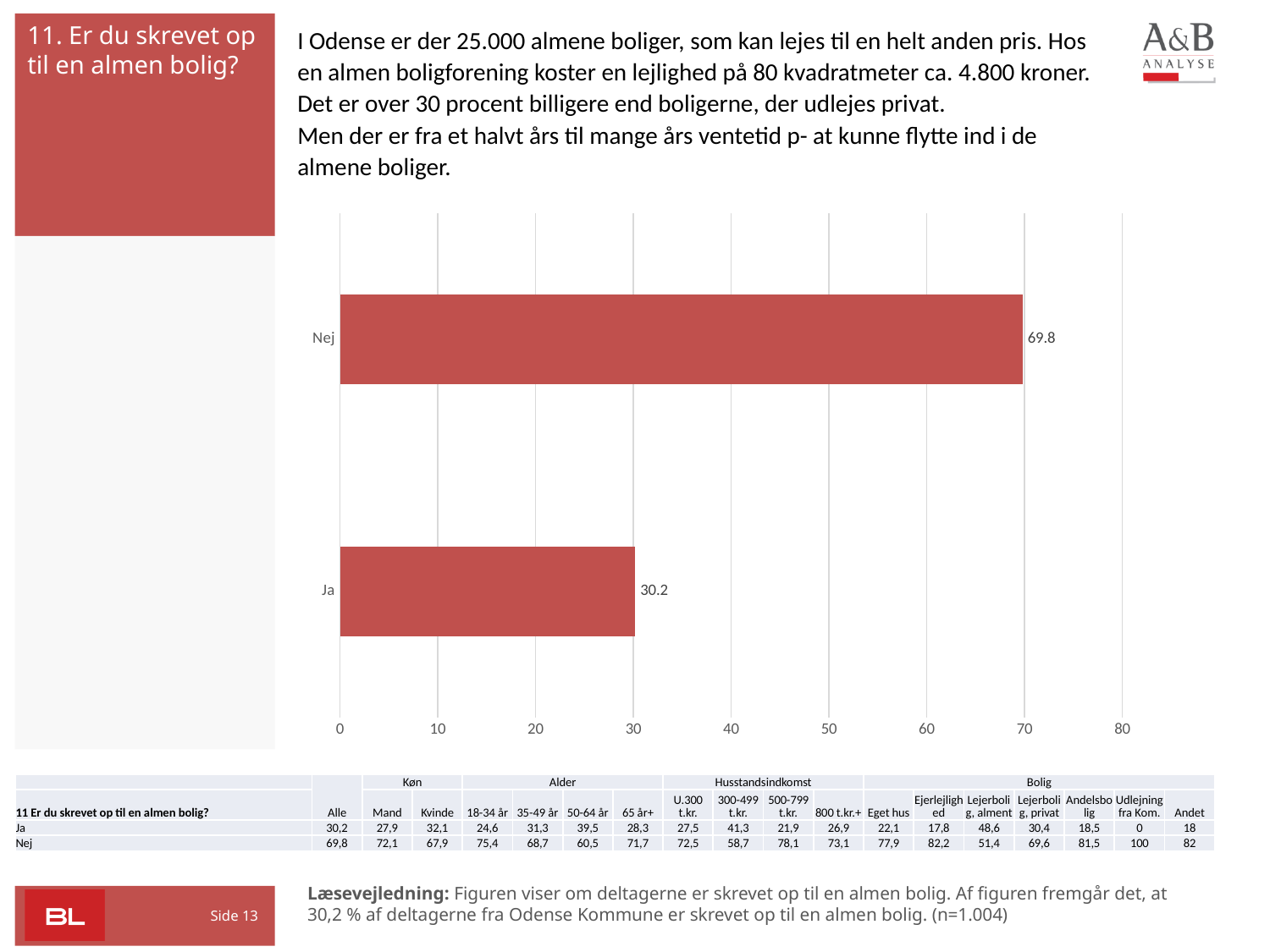
Which category has the lowest value in the chart? Ja What colour are the bars in the chart? red What is the value for "Nej" in the chart? 69.8 What is the difference between the values for "Nej" and "Ja"? 39.6 Is the value for "Ja" greater or less than 40? less What kind of chart is shown on the slide? bar chart Is the value for "Nej" greater or less than 60? greater Which category has the highest value in the chart? Nej How many categories are shown in the chart? 2 Which is larger, the value for "Ja" or the value for "Nej"? Nej What is the highest tick value shown on the horizontal axis of the chart? 80 What is the value for "Ja" in the chart? 30.2